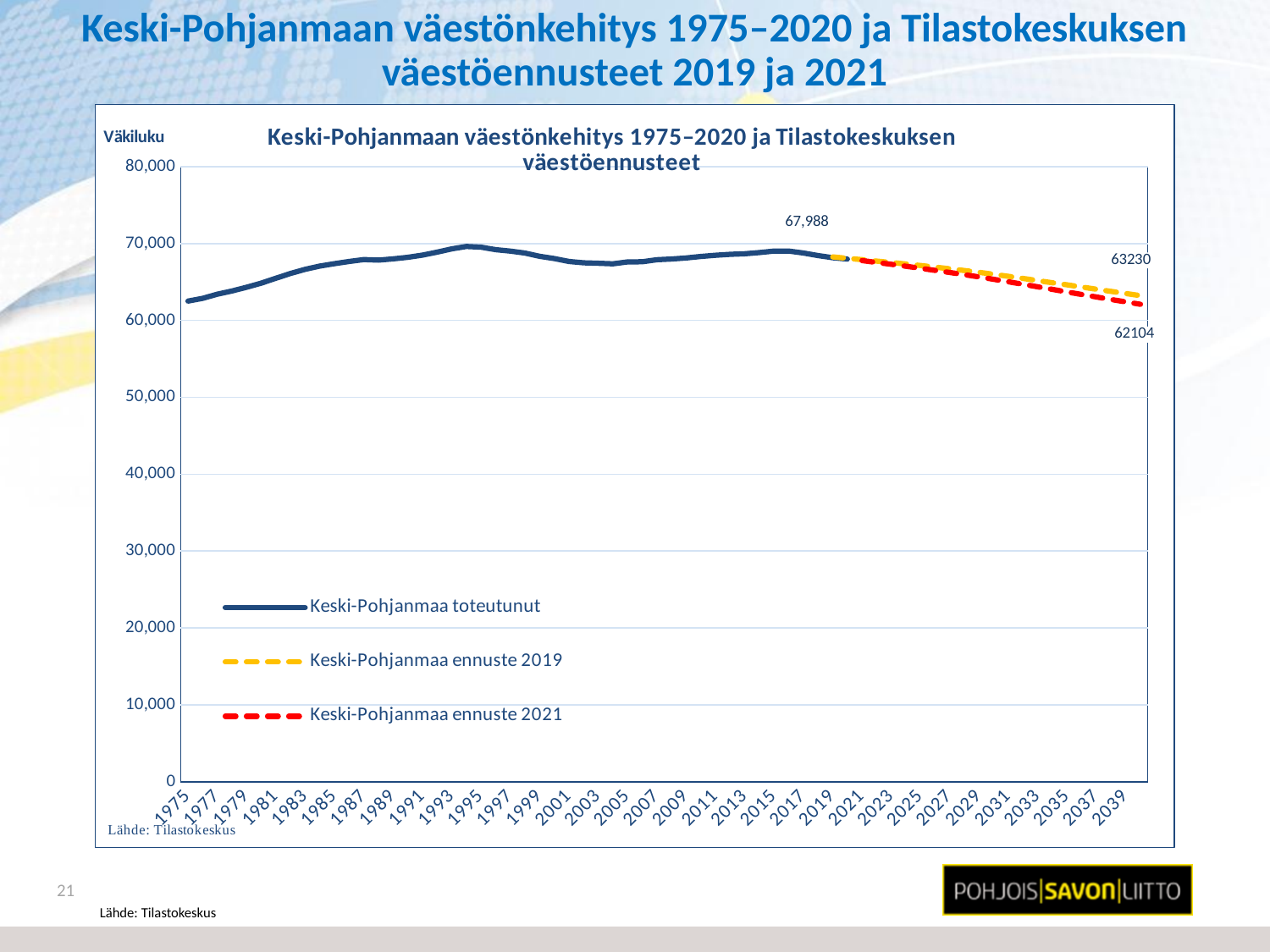
Is the value of the Keski-Pohjanmaa toteutunut series in 1975 greater or less than 60,000? greater What is the label on the vertical axis of the chart? Väkiluku How many series does the legend list? 3 Do the forecast series rise or fall from 2020 towards 2039? fall Is the value of the Keski-Pohjanmaa toteutunut series in 1995 greater or less than 80,000? less What is the difference between the end values of the ennuste 2019 series (63230) and the ennuste 2021 series (62104)? 1126 What kind of chart is shown on the slide? line chart What is the data label shown at the end of the Keski-Pohjanmaa toteutunut series? 67,988 What value is labelled at the end of the Keski-Pohjanmaa ennuste 2019 series? 63230 What is the difference between the labelled actual value 67,988 and the ennuste 2021 end value 62104? 5884 What value is labelled at the end of the Keski-Pohjanmaa ennuste 2021 series? 62104 Which forecast series ends at a higher value, ennuste 2019 or ennuste 2021? Keski-Pohjanmaa ennuste 2019